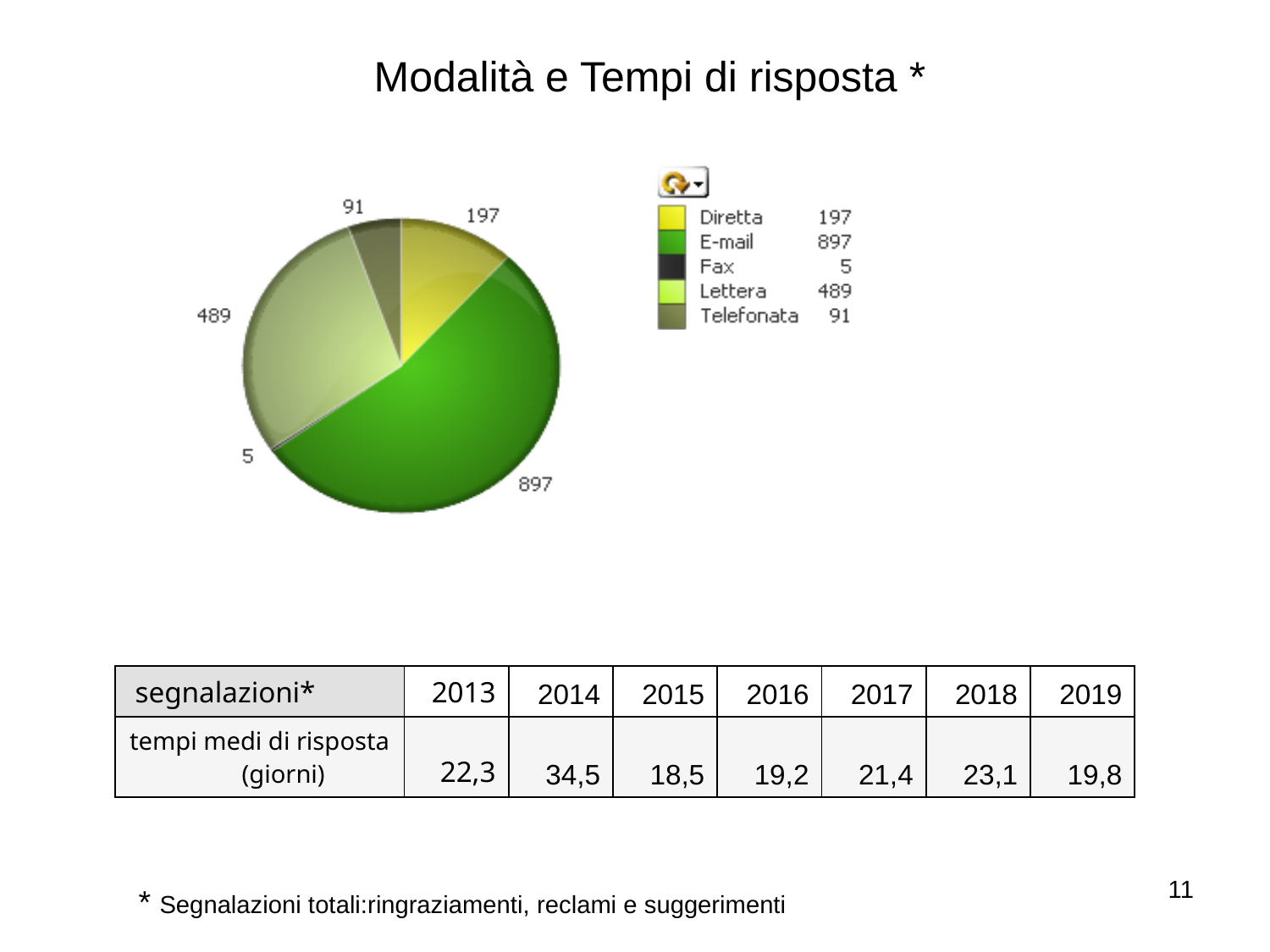
What is the difference between the E-mail and Lettera values in the pie chart? 408 Which colour represents Fax in the pie chart legend? Black How many categories does the pie chart have? 5 What kind of chart is shown on the slide? Pie chart Which category has the largest slice in the pie chart? E-mail What is the total of all the values in the pie chart? 1679 What value does the pie chart show for Telefonata? 91 What value does the pie chart show for Diretta? 197 What value does the pie chart show for E-mail? 897 What value does the pie chart show for Lettera? 489 Which category has the smallest slice in the pie chart? Fax Which is larger in the pie chart, Diretta or Telefonata? Diretta